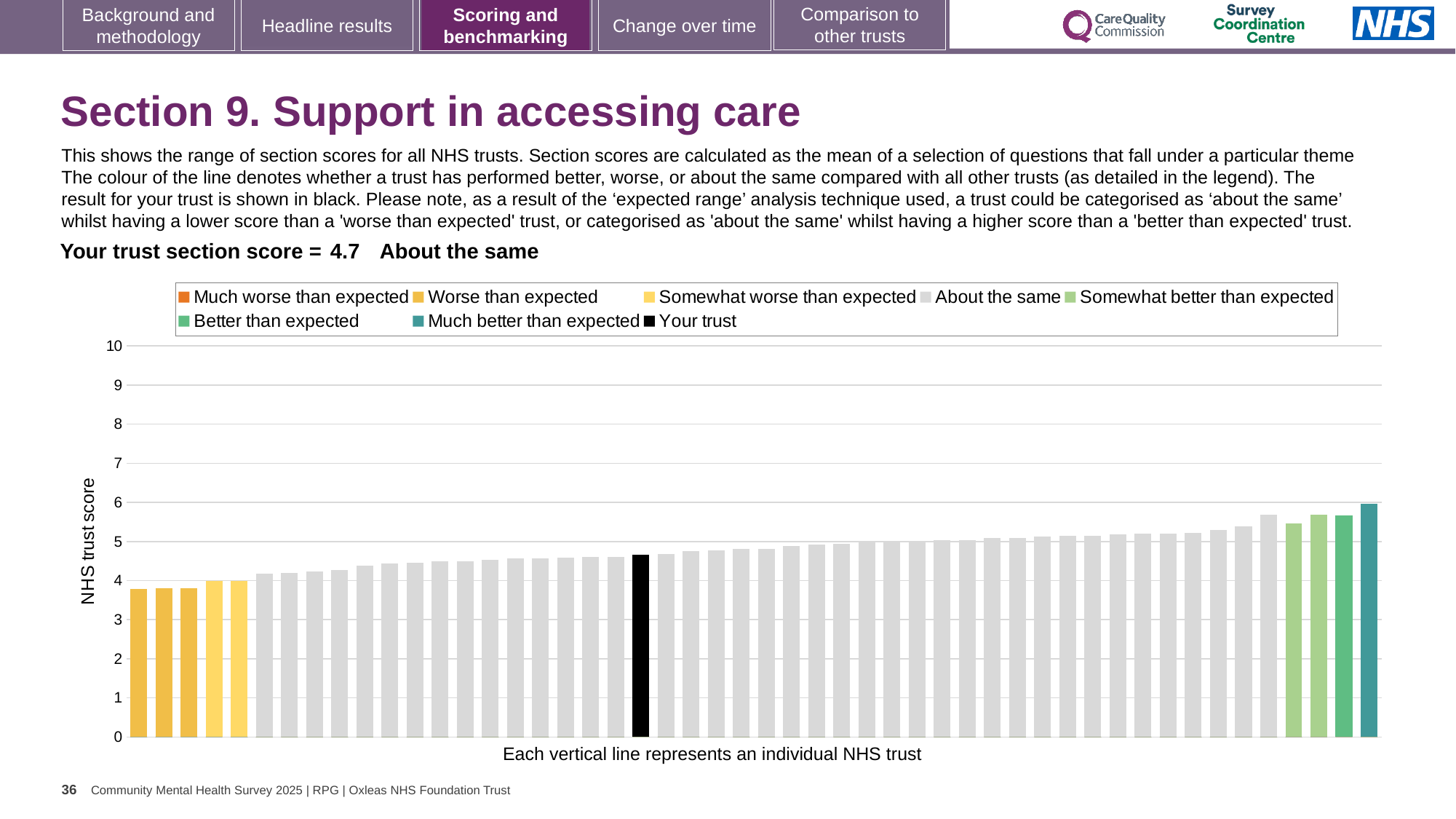
What colour is the bar representing your trust? Black Which is larger, the leftmost bar or the rightmost bar? The rightmost bar How many entries does the chart legend list? 8 Is the value of the tallest bar greater or less than 5? greater Which category does your trust's section score fall into according to the slide? About the same Is the value of the shortest bar greater or less than 4? less Do the bar values rise or fall from left to right along the x axis? Rise What is the section score for your trust shown on the slide? 4.7 Is the value of the tallest bar greater or less than 7? less What is the label on the vertical axis of the chart? NHS trust score What kind of chart is shown on the slide? Bar chart